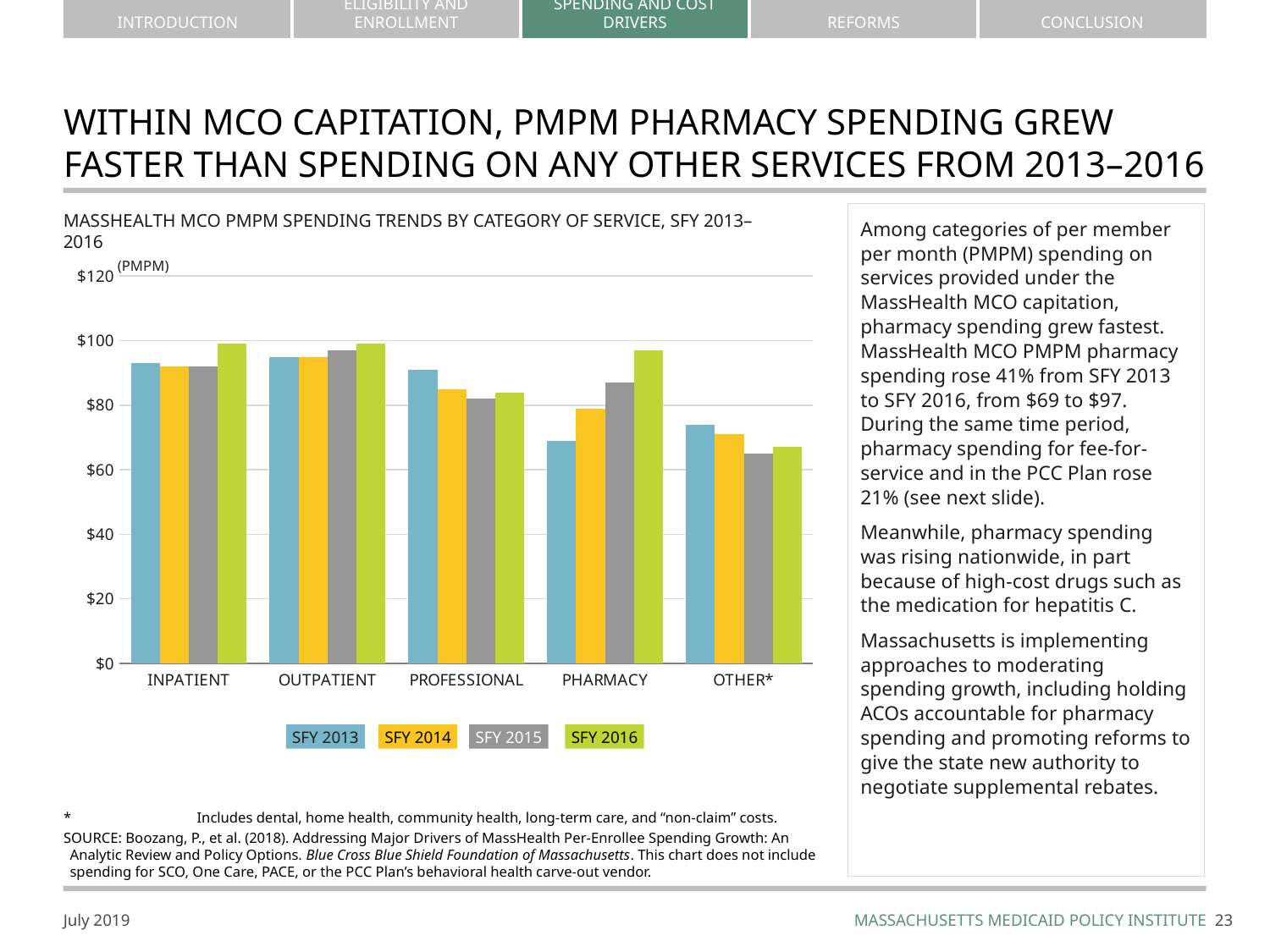
For the INPATIENT category, which fiscal year has the highest bar? SFY 2016 Is the SFY 2013 value for PHARMACY greater or less than $80? less What unit is indicated on the y axis of the chart? (PMPM) How many categories of service are shown on the x axis of the chart? 5 What kind of chart is shown on the slide? bar chart For the PHARMACY category, which fiscal year has the highest bar? SFY 2016 For the OTHER* category, which fiscal year has the lowest bar? SFY 2015 Is the SFY 2013 value for INPATIENT greater or less than $80? greater Do the PHARMACY bars rise or fall from SFY 2013 to SFY 2016? rise How many series does the chart's legend list? 4 Which is larger: the SFY 2016 value for INPATIENT or the SFY 2016 value for PROFESSIONAL? INPATIENT Which fiscal years are listed in the chart's legend? SFY 2013, SFY 2014, SFY 2015, SFY 2016